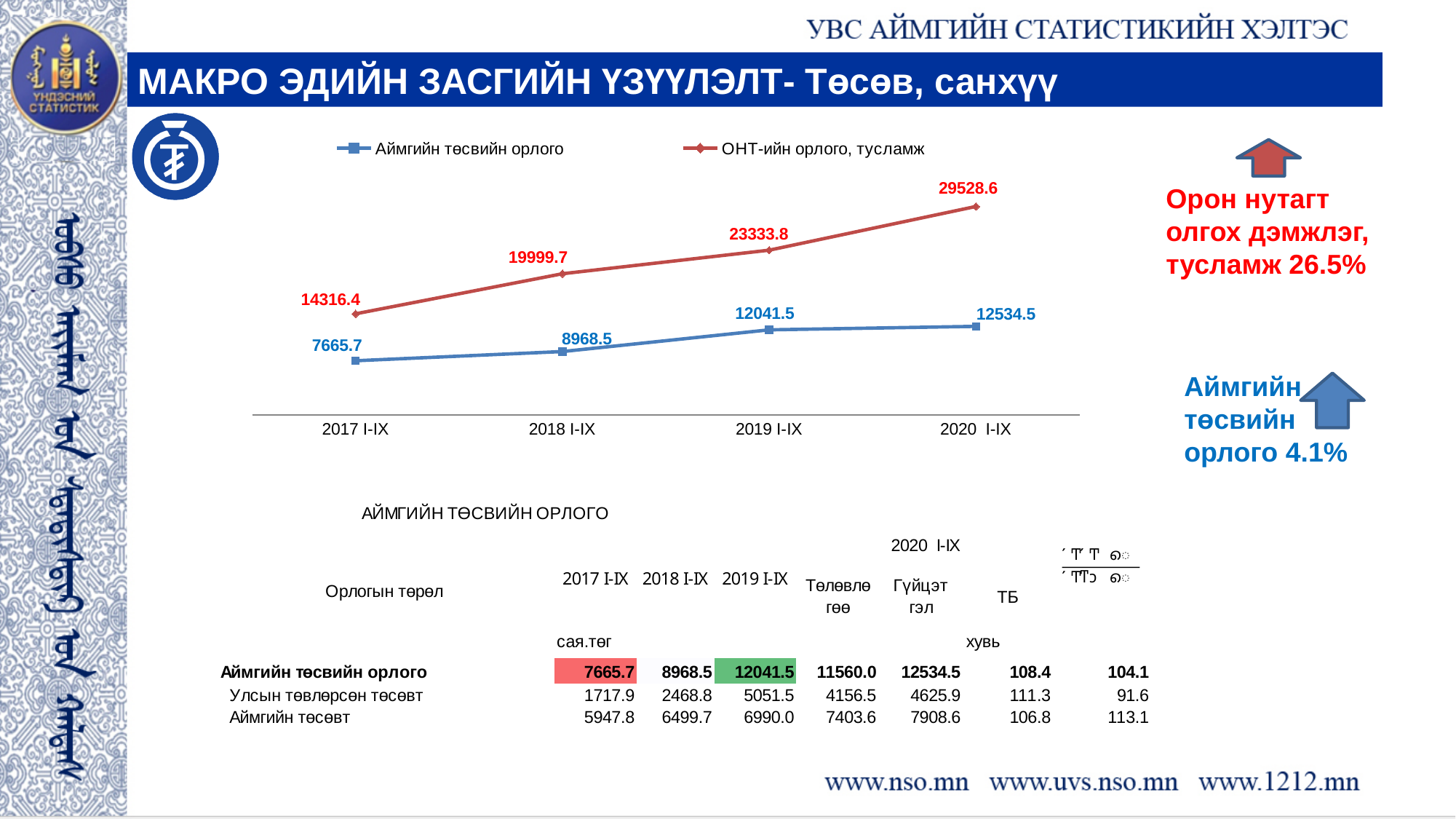
Does Аймгийн төсвийн орлого rise or fall from 2017 I-IX to 2020 I-IX? rise How many periods are plotted along the x axis of the chart? 4 What is the difference between ОНТ-ийн орлого, тусламж and Аймгийн төсвийн орлого in 2019 I-IX? 11292.3 What is the value of ОНТ-ийн орлого, тусламж for 2020 I-IX? 29528.6 What is the value of Аймгийн төсвийн орлого for 2017 I-IX? 7665.7 What type of chart is shown on the slide? line chart In which period is Аймгийн төсвийн орлого highest? 2020 I-IX Which series has the larger value in 2018 I-IX, Аймгийн төсвийн орлого or ОНТ-ийн орлого, тусламж? ОНТ-ийн орлого, тусламж What is the value of ОНТ-ийн орлого, тусламж for 2018 I-IX? 19999.7 How many series does the chart legend list? 2 In which period is ОНТ-ийн орлого, тусламж lowest? 2017 I-IX Which colour is used for the ОНТ-ийн орлого, тусламж line? red